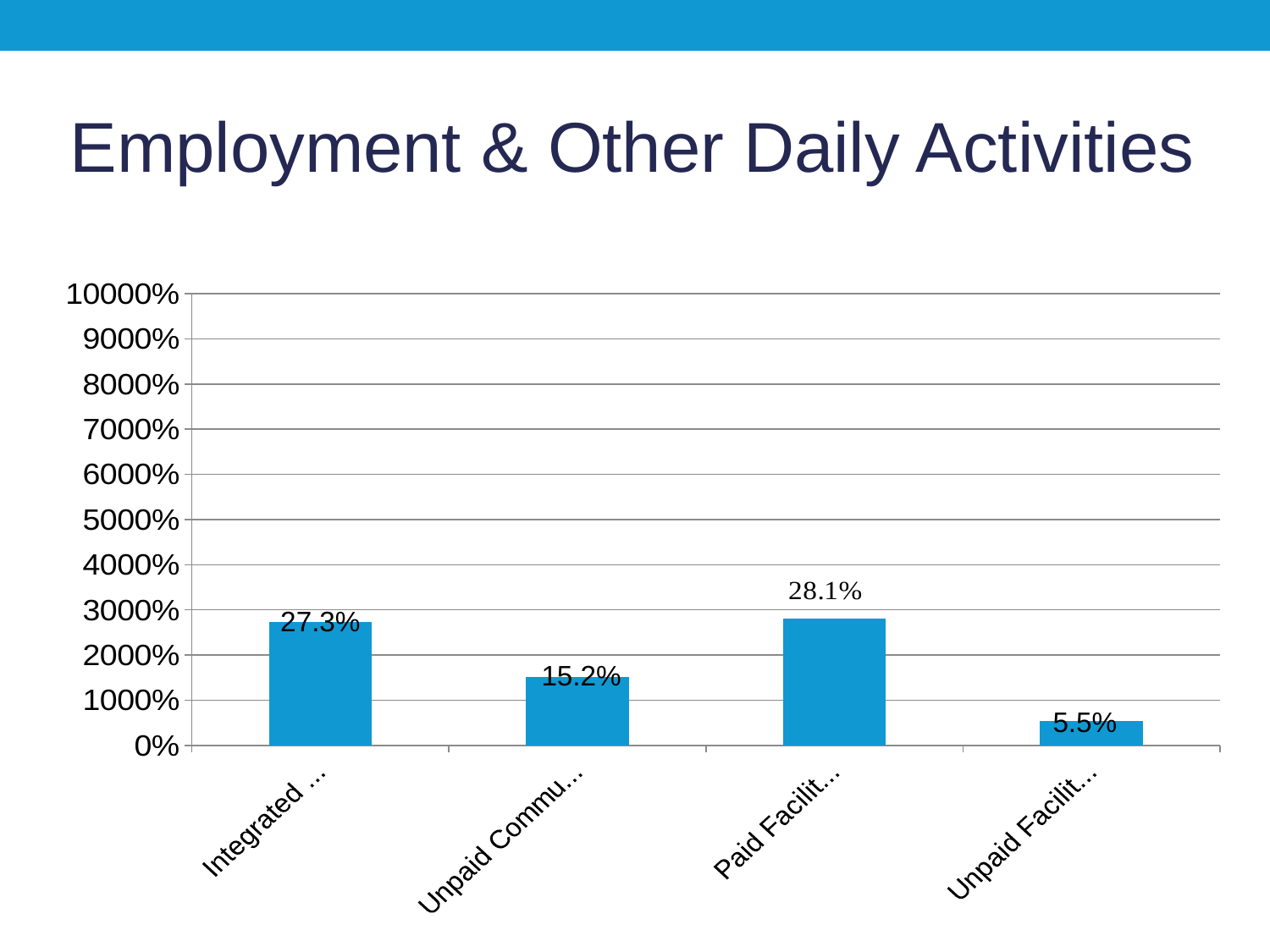
Which category has the highest value? Paid Facilit... What is the title of the slide containing the chart? Employment & Other Daily Activities How many bars are plotted in the chart? 4 What is the difference between the values for 'Paid Facilit...' and 'Integrated ...'? 0.8% Which category has the lowest value? Unpaid Facilit... What is the value shown for the bar labelled 'Unpaid Facilit...'? 5.5% What is the value shown for the bar labelled 'Integrated ...'? 27.3% Which is larger, the value for 'Unpaid Commu...' or the value for 'Unpaid Facilit...'? Unpaid Commu... What is the value shown for the bar labelled 'Paid Facilit...'? 28.1% What kind of chart is shown on the slide? Bar chart What is the value shown for the bar labelled 'Unpaid Commu...'? 15.2% What is the difference between the values for 'Integrated ...' and 'Unpaid Commu...'? 12.1%